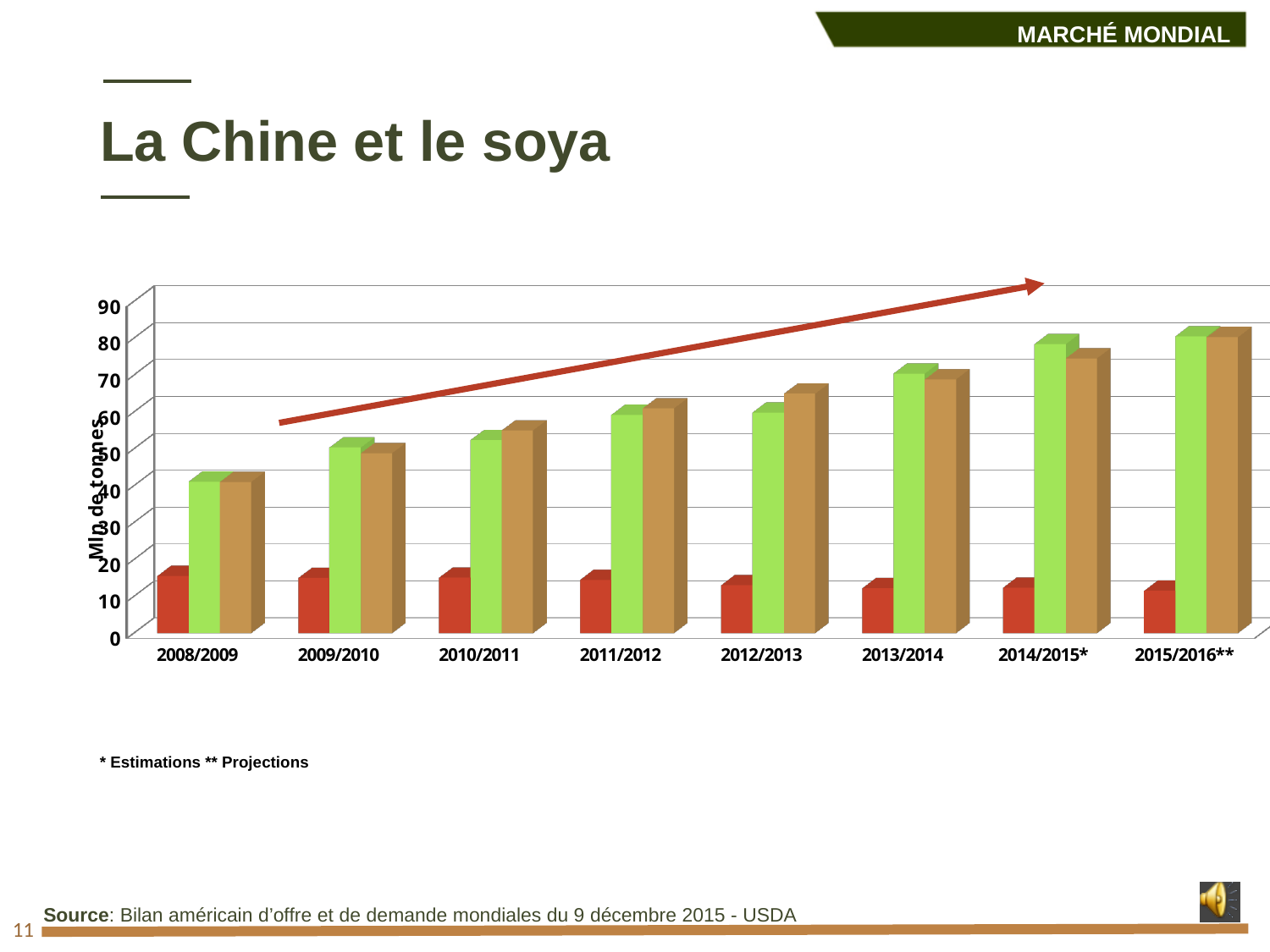
Which season has the highest green bar? 2015/2016** Is the value of the green bar for 2015/2016** greater or less than 70? greater What is the label on the vertical axis of the chart? Mln de tonnes Which is larger: the red bar for 2008/2009 or the red bar for 2015/2016**? 2008/2009 Is the value of the green bar for 2008/2009 greater or less than 30? greater Do the green bars rise or fall from 2008/2009 to 2015/2016**? rise Which season has the lowest green bar? 2008/2009 What is the title of the slide containing the chart? La Chine et le soya How many seasons (categories) are shown along the x axis of the chart? 8 Is the value of the red bar for 2008/2009 greater or less than 20? less What kind of chart is shown on the slide? bar chart Do the red bars rise or fall from 2008/2009 to 2015/2016**? fall